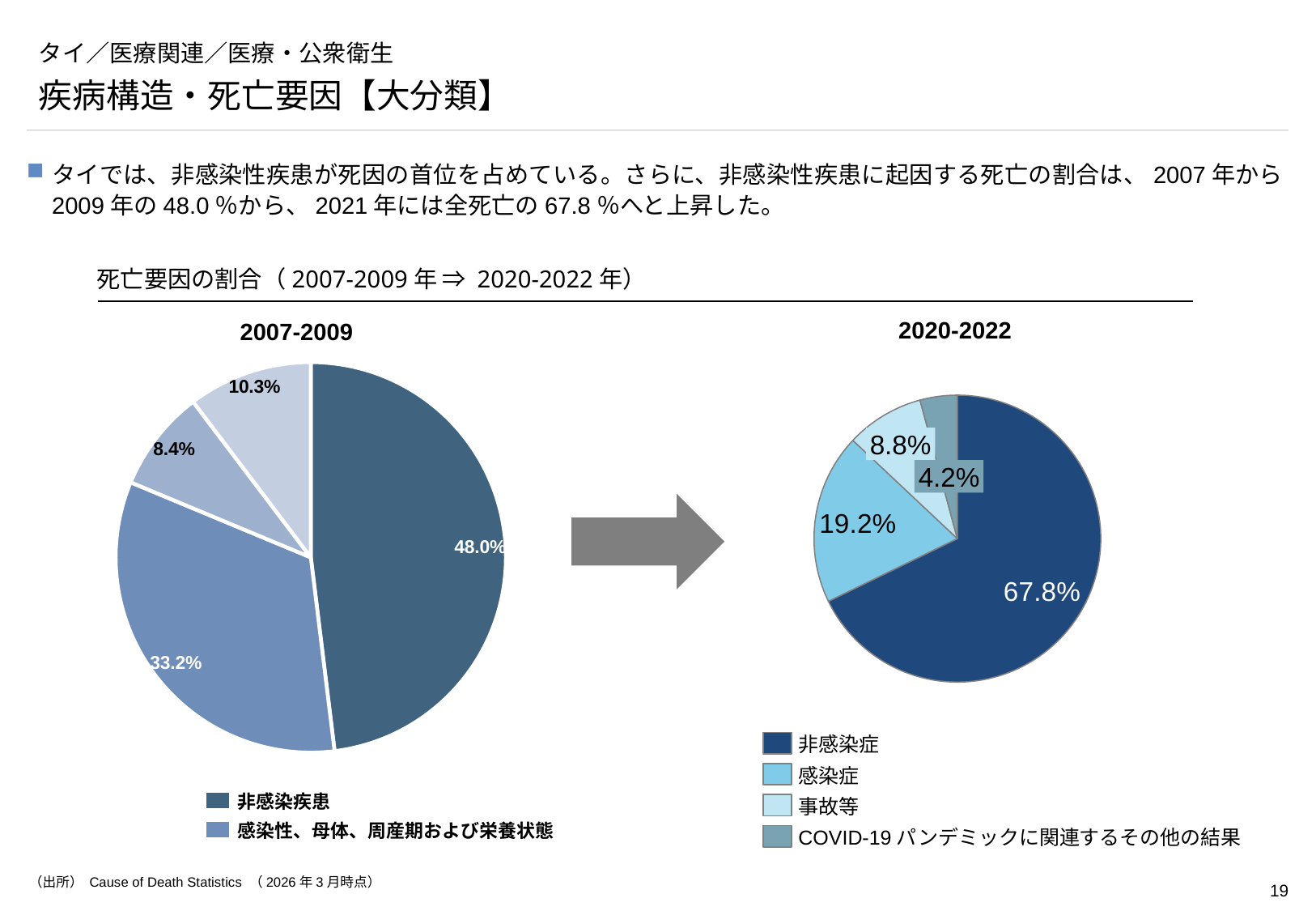
In the 2007-2009 pie chart, what percentage is shown for 感染性、母体、周産期および栄養状態? 33.2% In the 2020-2022 pie chart, how many percentage points larger is 非感染症 than 感染症? 48.6 percentage points In the 2020-2022 pie chart, which category has the smallest share? COVID-19 パンデミックに関連するその他の結果 In the 2020-2022 pie chart, which category has the largest share? 非感染症 In the 2020-2022 pie chart, what percentage is shown for 感染症? 19.2% Which is larger: the non-communicable disease share in the 2007-2009 pie chart or in the 2020-2022 pie chart? 2020-2022 How many entries does the legend of the 2020-2022 chart list? 4 In the 2020-2022 pie chart, what percentage is shown for 事故等? 8.8% In the 2020-2022 pie chart, what percentage is shown for 非感染症? 67.8% How many slices does the 2007-2009 pie chart have? 4 In the 2007-2009 pie chart, what percentage is shown for 非感染疾患? 48.0% In the 2020-2022 pie chart, what percentage is shown for COVID-19 パンデミックに関連するその他の結果? 4.2%